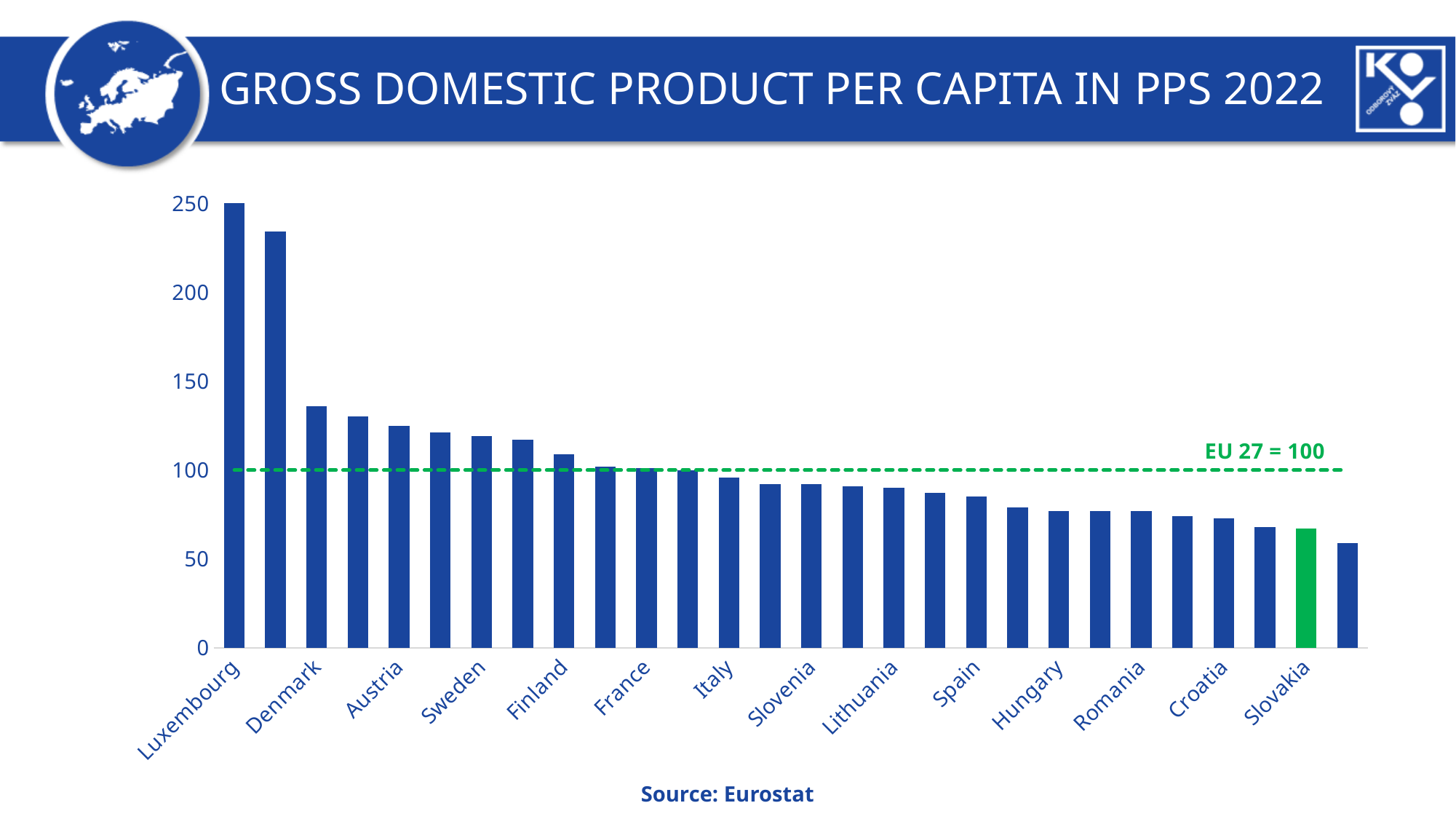
Do the values rise or fall moving from left to right along the x axis? fall Is the value for Austria greater or less than 150? less Is the value for Croatia greater or less than 50? greater Which has a higher value, Spain or Croatia? Spain Which country's bar is highlighted in green? Slovakia Which country has the highest GDP per capita in PPS on the chart? Luxembourg Is the value for Sweden greater or less than 100? greater Which has a higher value, Sweden or Finland? Sweden What kind of chart is shown on the slide? bar chart